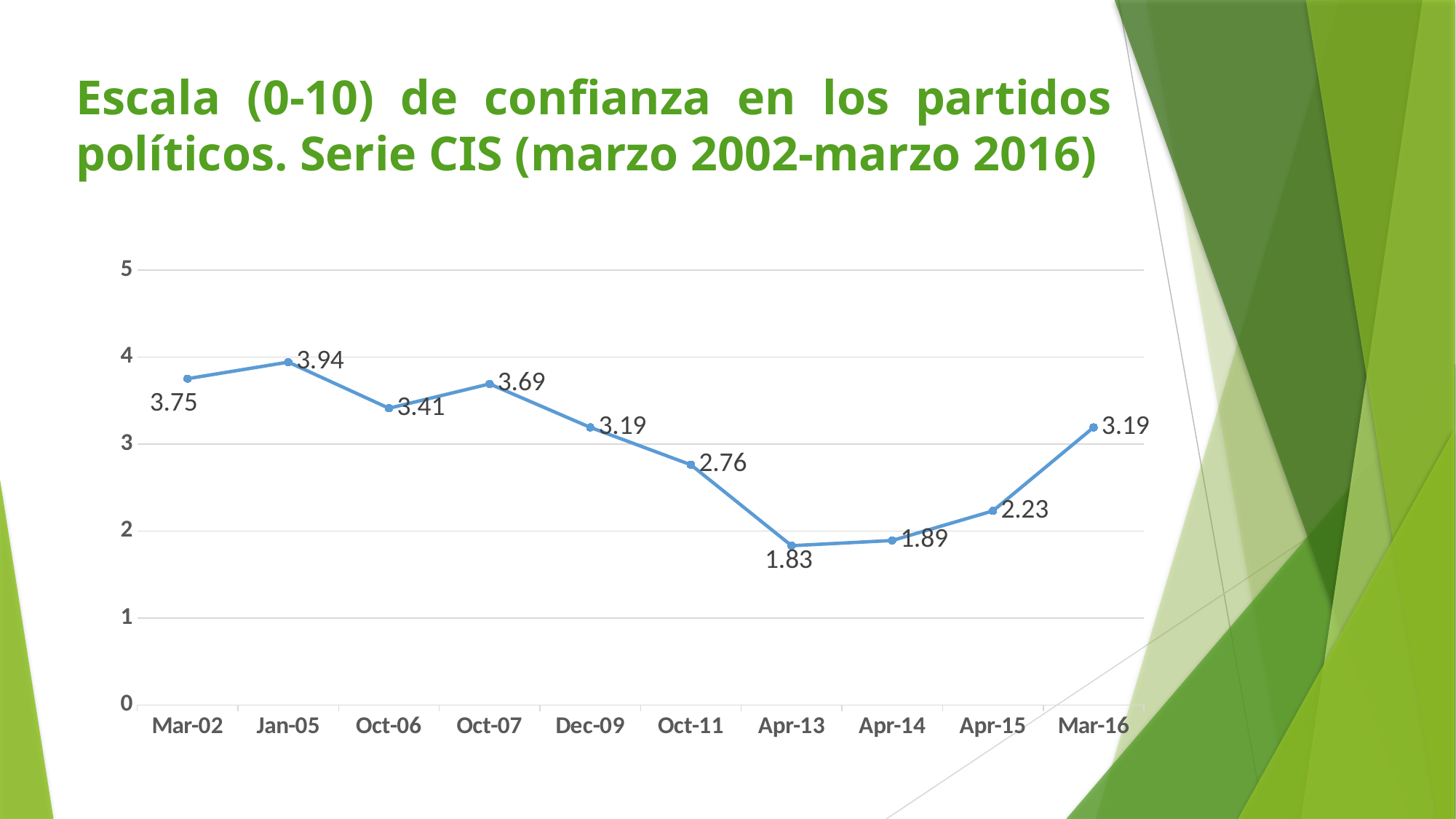
What is the value for Apr-13? 1.83 What is the value for Mar-16? 3.19 Is the value for Oct-11 greater or less than 3? less What is the difference between the values for Jan-05 and Apr-13? 2.11 Which date has the highest value? Jan-05 Which is larger, the value for Oct-06 or the value for Oct-07? Oct-07 What kind of chart is shown on the slide? line chart How many data points are plotted on the chart? 10 What is the value for Mar-02? 3.75 Do the values rise or fall from Apr-13 to Mar-16? rise What is the difference between the values for Mar-16 and Apr-15? 0.96 Which date has the lowest value? Apr-13